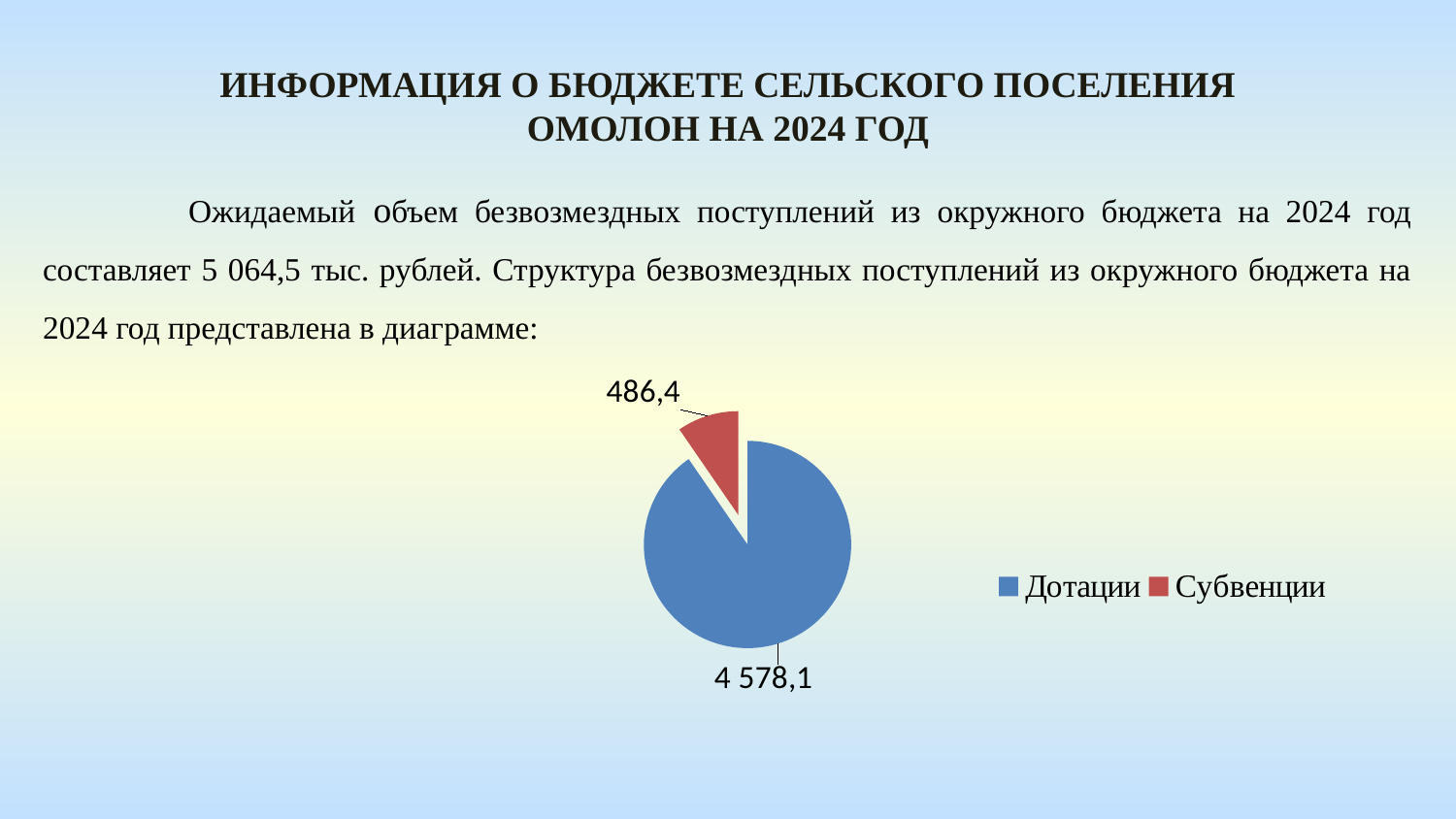
What is the difference between the values for Дотации and Субвенции? 4 091,7 What type of chart is shown on the slide? pie chart Which category has the smallest slice in the pie chart? Субвенции What is the value for Дотации in the pie chart? 4 578,1 Which is larger, Дотации or Субвенции? Дотации Which category has the largest slice in the pie chart? Дотации What is the total of the two slices in the pie chart? 5 064,5 What is the value for Субвенции in the pie chart? 486,4 What colour is the Субвенции slice in the pie chart? red How many categories does the pie chart have? 2